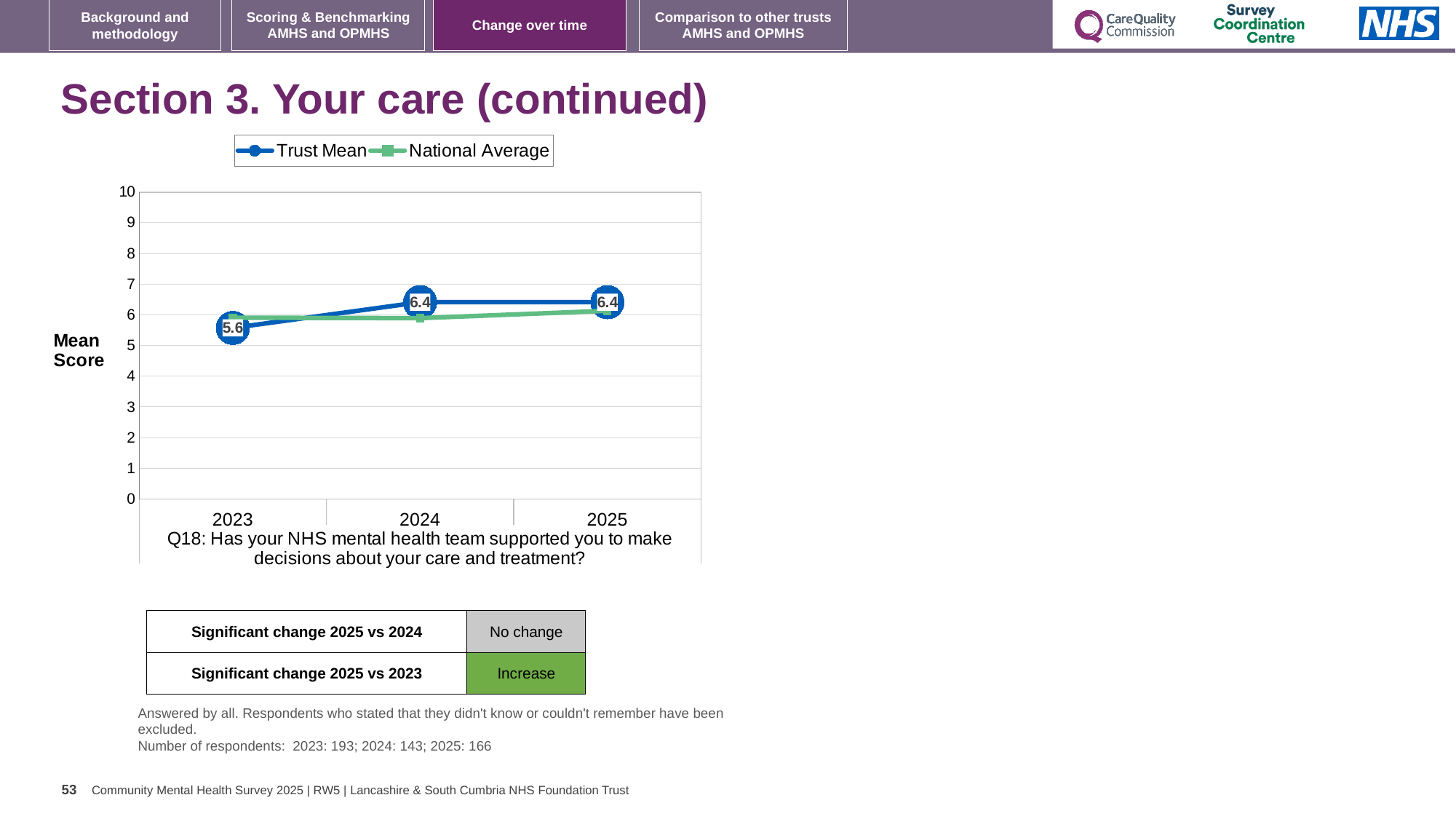
Which year has the larger Trust Mean score, 2023 or 2024? 2024 How many years are shown on the x axis of the chart? 3 Is the National Average value for 2023 greater or less than 5? greater What is the difference between the Trust Mean scores for 2024 and 2023? 0.8 In which year is the Trust Mean score lowest? 2023 What is the Trust Mean score for 2024? 6.4 What is the Trust Mean score for 2025? 6.4 Is the National Average value for 2025 greater or less than 7? less Does the Trust Mean score rise or fall from 2023 to 2025? rise What kind of chart is shown on the slide? line chart How many series does the chart legend list? 2 What is the Trust Mean score for 2023? 5.6